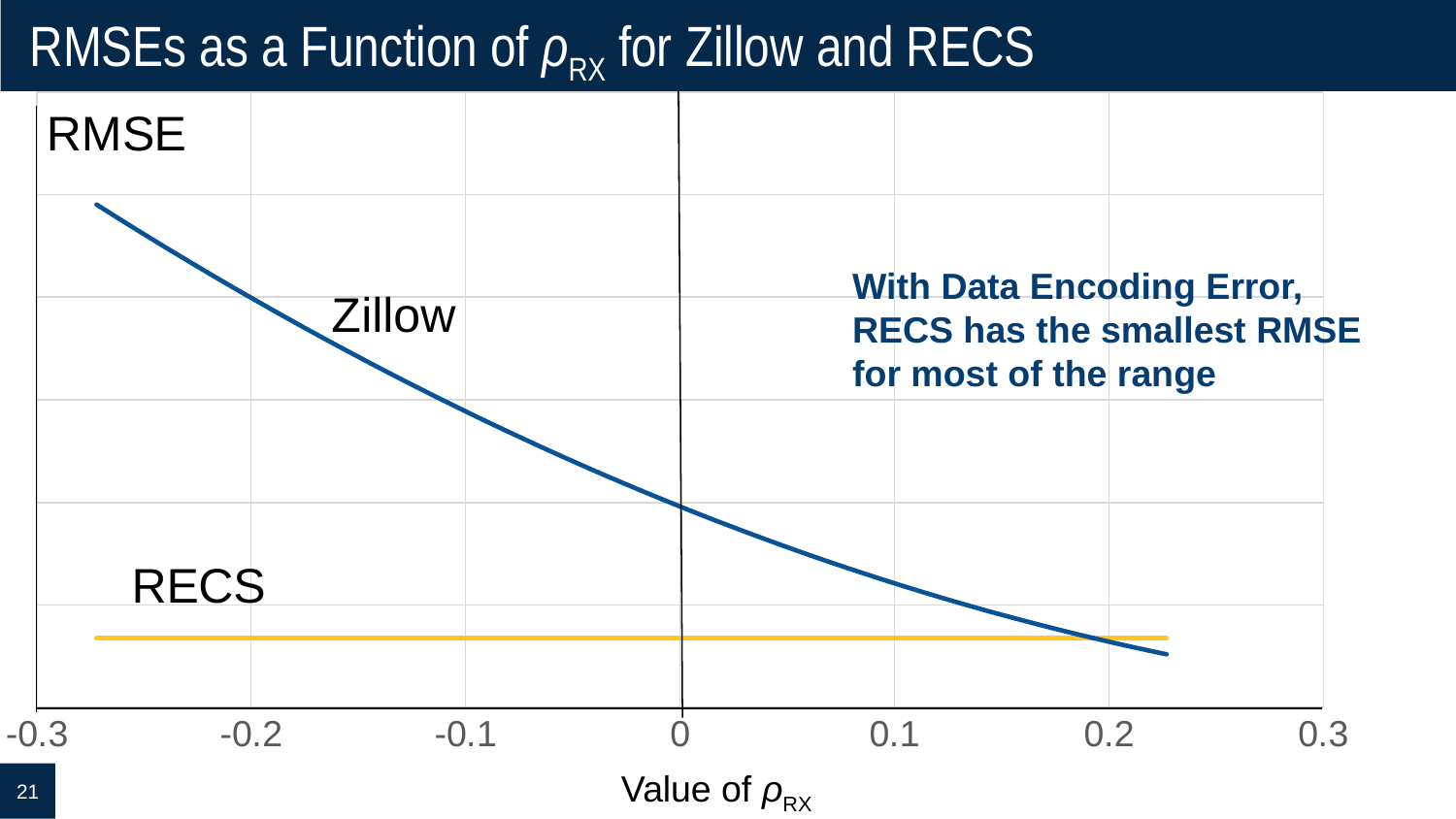
What kind of chart is shown on the slide? line chart At ρRX = 0, which series has the larger RMSE, Zillow or RECS? Zillow Which two series are plotted on the chart? Zillow and RECS What is the highest value shown on the x axis? 0.3 What is the label of the x axis? Value of ρRX Which series has the highest RMSE at the left end of the chart? Zillow What is the lowest value shown on the x axis? -0.3 At ρRX = -0.2, which series has the smaller RMSE, Zillow or RECS? RECS Does the RECS line rise, fall, or stay flat as the value of ρRX increases? stay flat What is the title of the chart? RMSEs as a Function of ρRX for Zillow and RECS How many series are plotted on the chart? 2 Does the Zillow line rise or fall as the value of ρRX increases along the x axis? fall